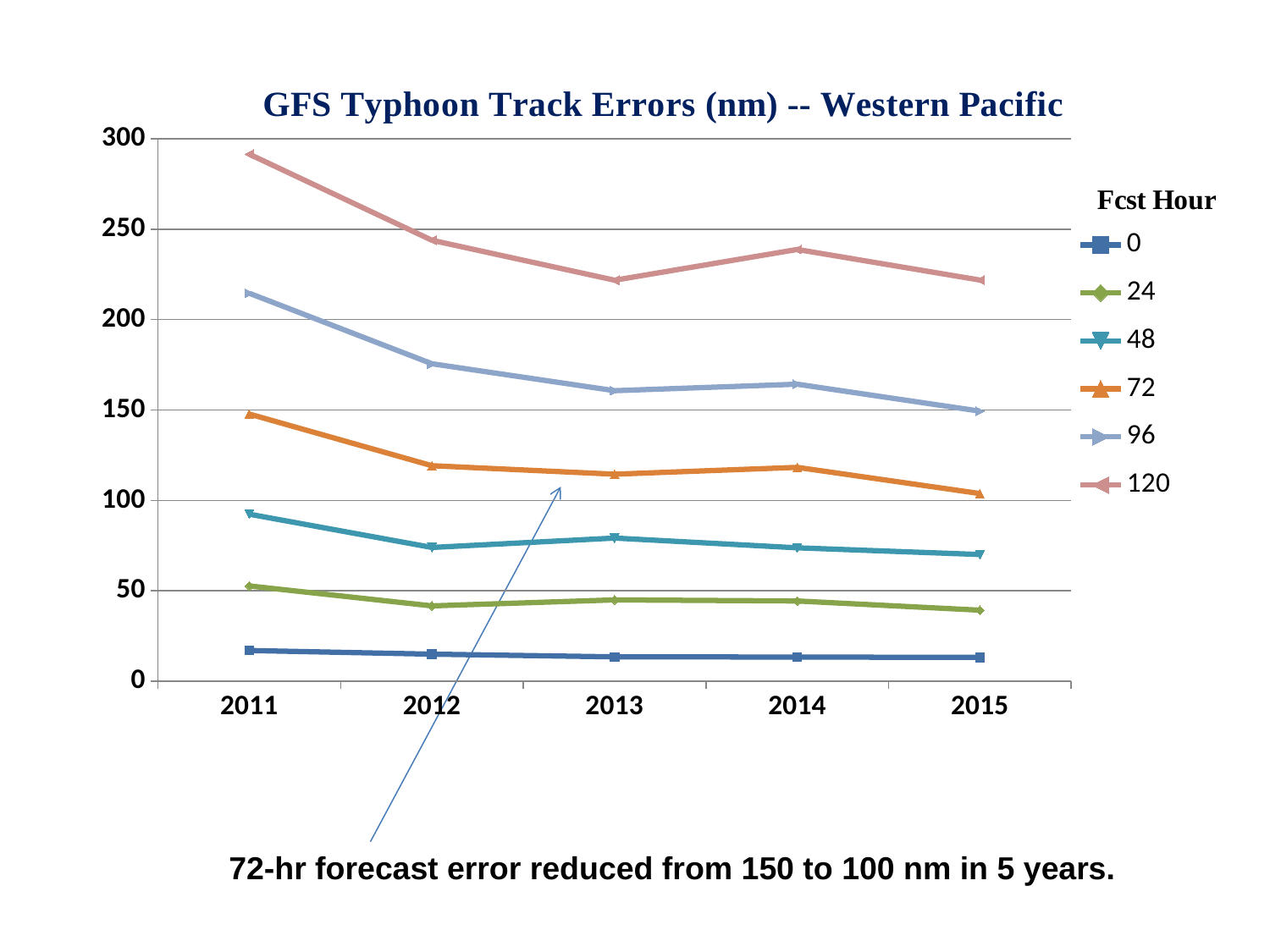
Is the 96-hour forecast error in 2015 greater or less than 200? less What kind of chart is shown on the slide? line chart Which is larger in 2014: the 120-hour error or the 96-hour error? 120-hour Which forecast hour has the lowest track error in 2015? 0 How many years are plotted along the x axis? 5 Which forecast hour has the highest track error in 2011? 120 Is the 48-hour forecast error in 2012 greater or less than 100? less Does the 96-hour forecast error rise or fall from 2011 to 2015? fall In which year is the 96-hour forecast error lowest? 2015 In which year is the 120-hour forecast error highest? 2011 Is the 120-hour forecast error in 2011 greater or less than 250? greater How many series does the legend list? 6